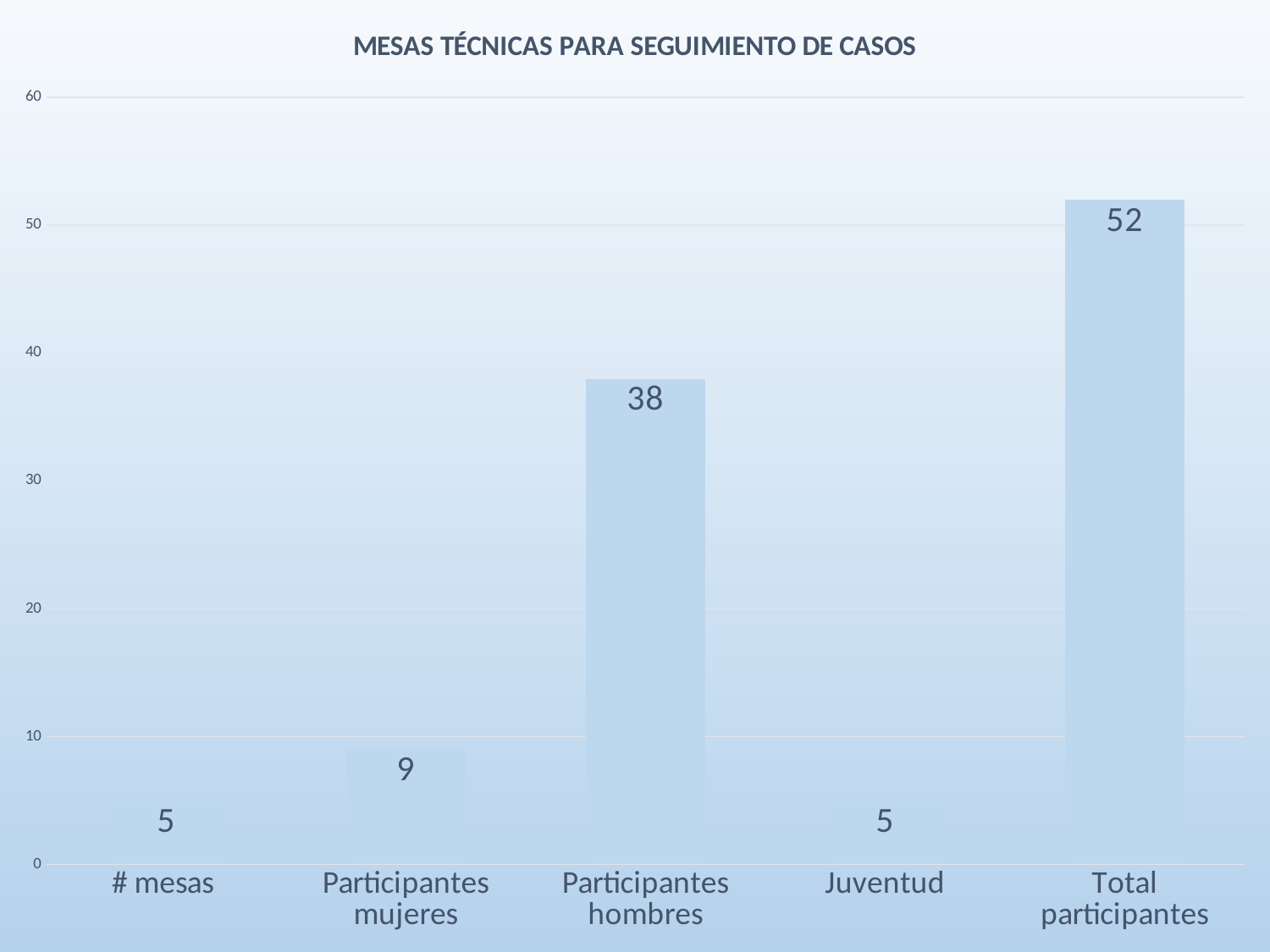
What kind of chart is shown on the slide? bar chart Which is larger, Participantes mujeres or Participantes hombres? Participantes hombres What is the value for Juventud? 5 How many categories are shown on the x axis? 5 Which category has the highest value? Total participantes Is the value for Participantes hombres greater or less than 40? less What is the value for Total participantes? 52 What is the difference between Participantes hombres and Participantes mujeres? 29 What is the difference between Total participantes and Participantes hombres? 14 What is the value for Participantes hombres? 38 What is the value for Participantes mujeres? 9 What is the title of the chart? MESAS TÉCNICAS PARA SEGUIMIENTO DE CASOS